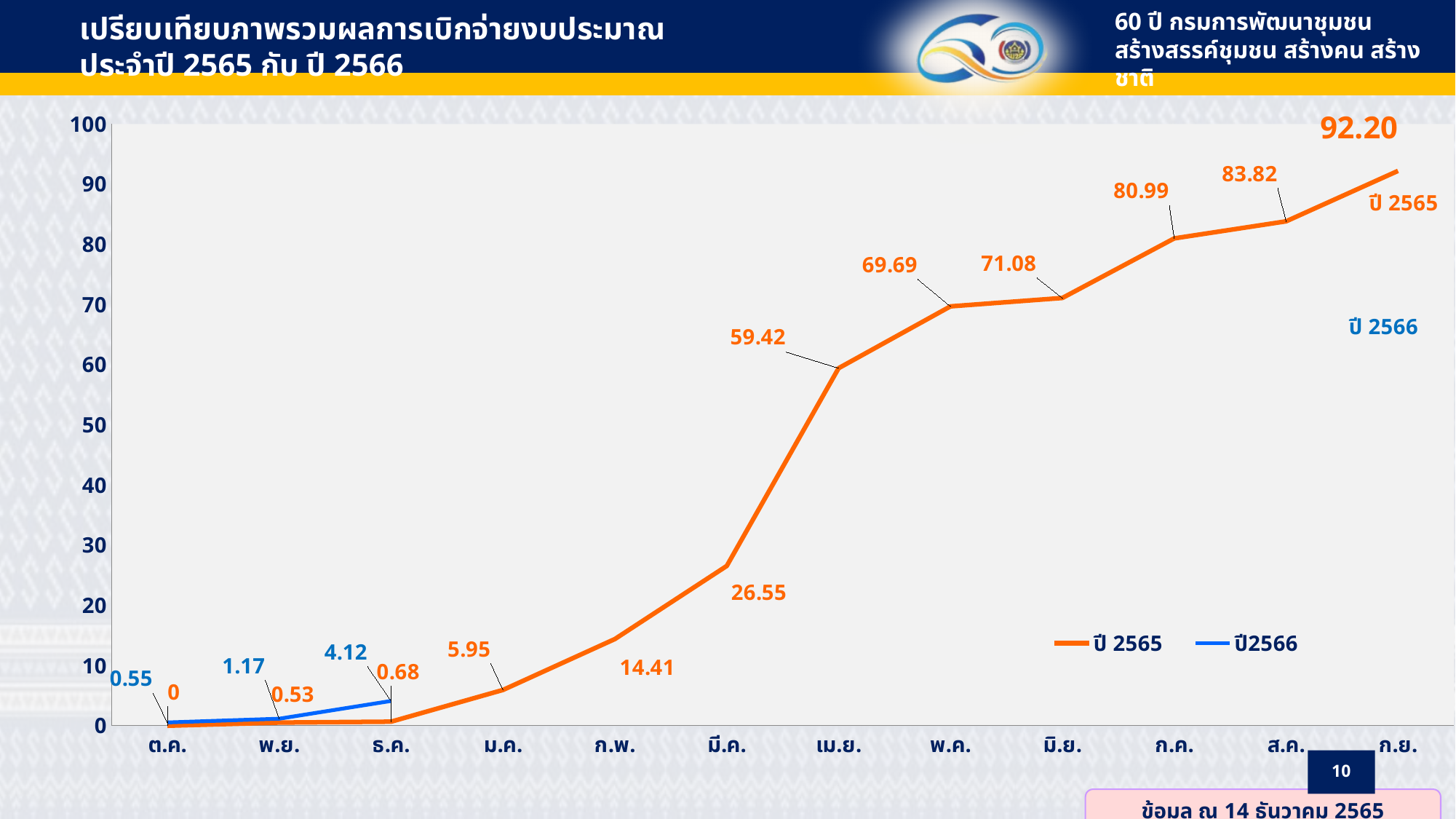
Does the ปี 2565 line rise or fall from ต.ค. to ก.ย.? rise In which month is the ปี 2565 value highest? ก.ย. What is the value for ปี 2565 in ก.ย.? 92.20 What is the difference between the ปี 2565 values in ก.ย. and ส.ค.? 8.38 What type of chart is shown on the slide? line chart In ธ.ค., which series has the larger value, ปี 2565 or ปี2566? ปี2566 How many months are shown on the x axis? 12 What is the value for ปี2566 in ต.ค.? 0.55 What is the value for ปี 2565 in เม.ย.? 59.42 How many series does the legend list? 2 What is the value for ปี2566 in ธ.ค.? 4.12 In which month is the ปี 2565 value lowest? ต.ค.